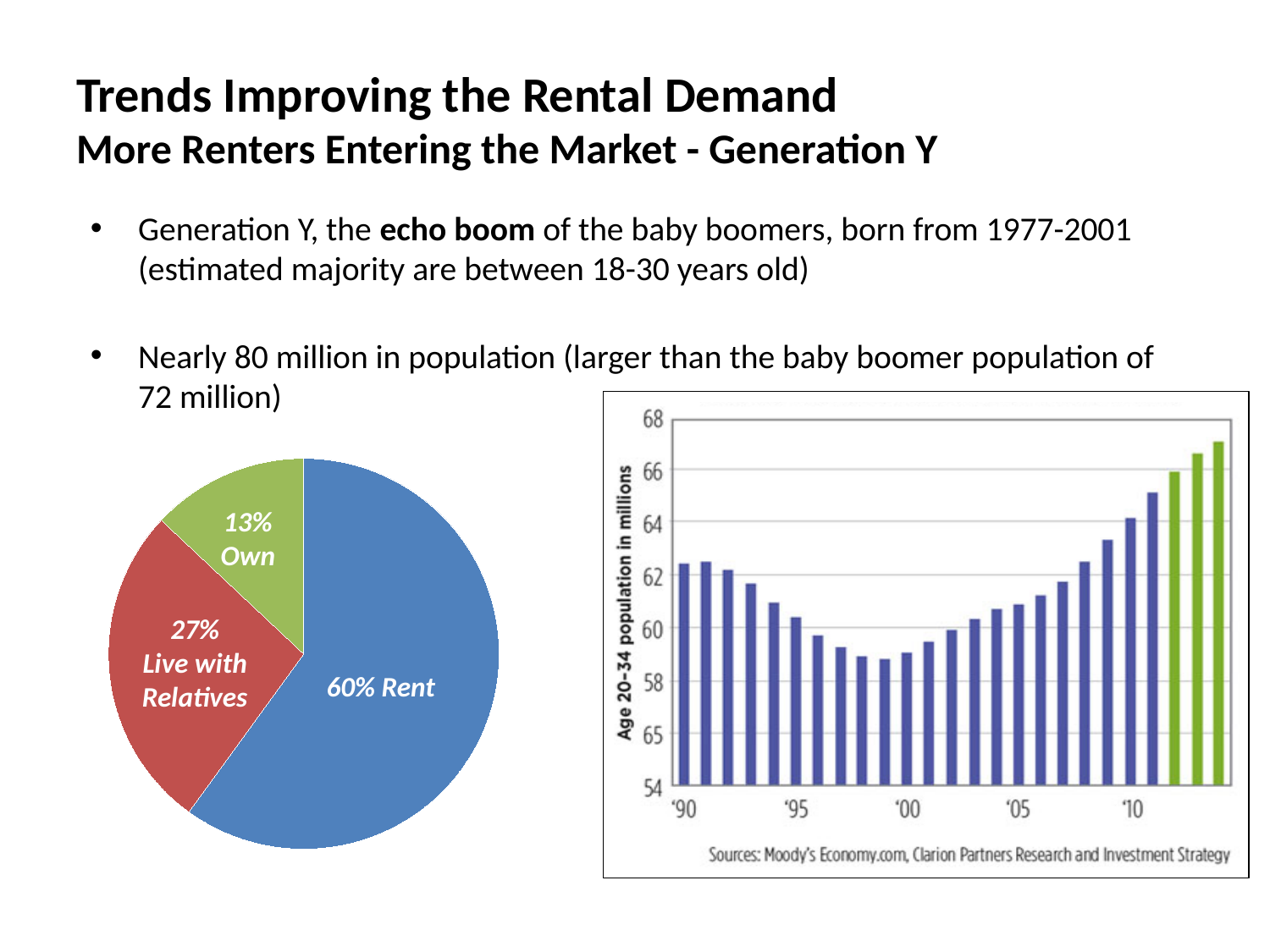
On the pie chart, which category has the smallest share? Own On the right-hand bar chart, which is larger, the value for '90 or the value for '00? '90 What kind of chart is the chart on the left of the slide? Pie chart On the pie chart, which category has the largest share? Rent How many slices does the pie chart have? 3 On the right-hand bar chart, is the value for '00 greater or less than 60? less On the right-hand bar chart, do the values rise or fall from '00 to the last bar? rise On the pie chart, what share of Generation Y rents? 60% On the pie chart, what is the difference in percentage points between Rent and Live with Relatives? 33 On the pie chart, what percentage live with relatives? 27% What kind of chart is the chart on the right of the slide? Bar chart On the pie chart, what percentage own? 13%